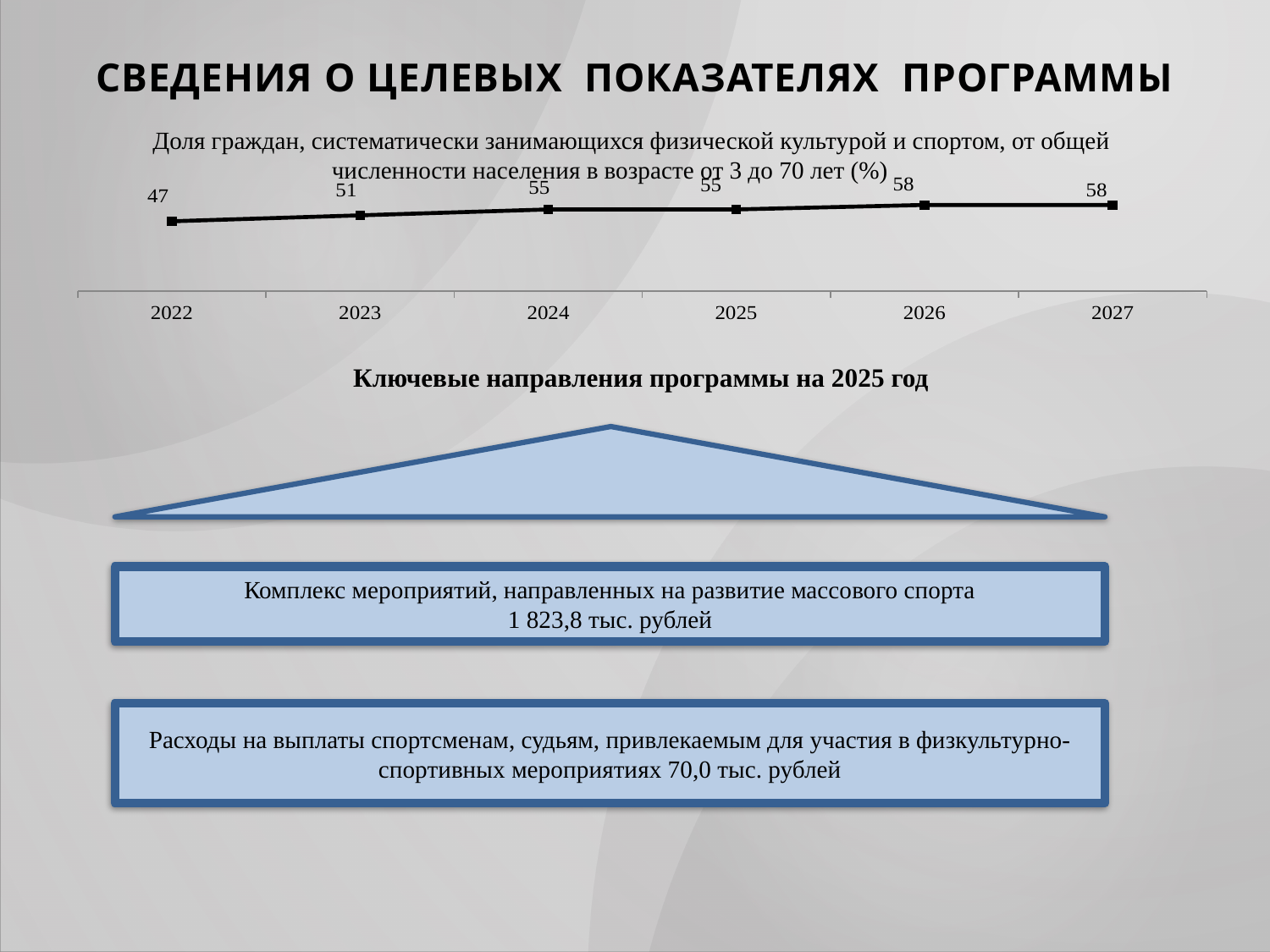
What is the difference between the values for 2027 and 2022? 11 How many data points are plotted on the chart? 6 What is the value for 2022? 47 What kind of chart is shown on the slide? line chart Which year has the lowest value? 2022 What unit is given in the chart title? % What is the value for 2024? 55 What is the difference between the values for 2023 and 2022? 4 Do the values rise or fall from 2022 to 2027? rise What is the value for 2027? 58 What is the first year shown on the x axis? 2022 Which is larger, the value for 2023 or the value for 2026? 2026